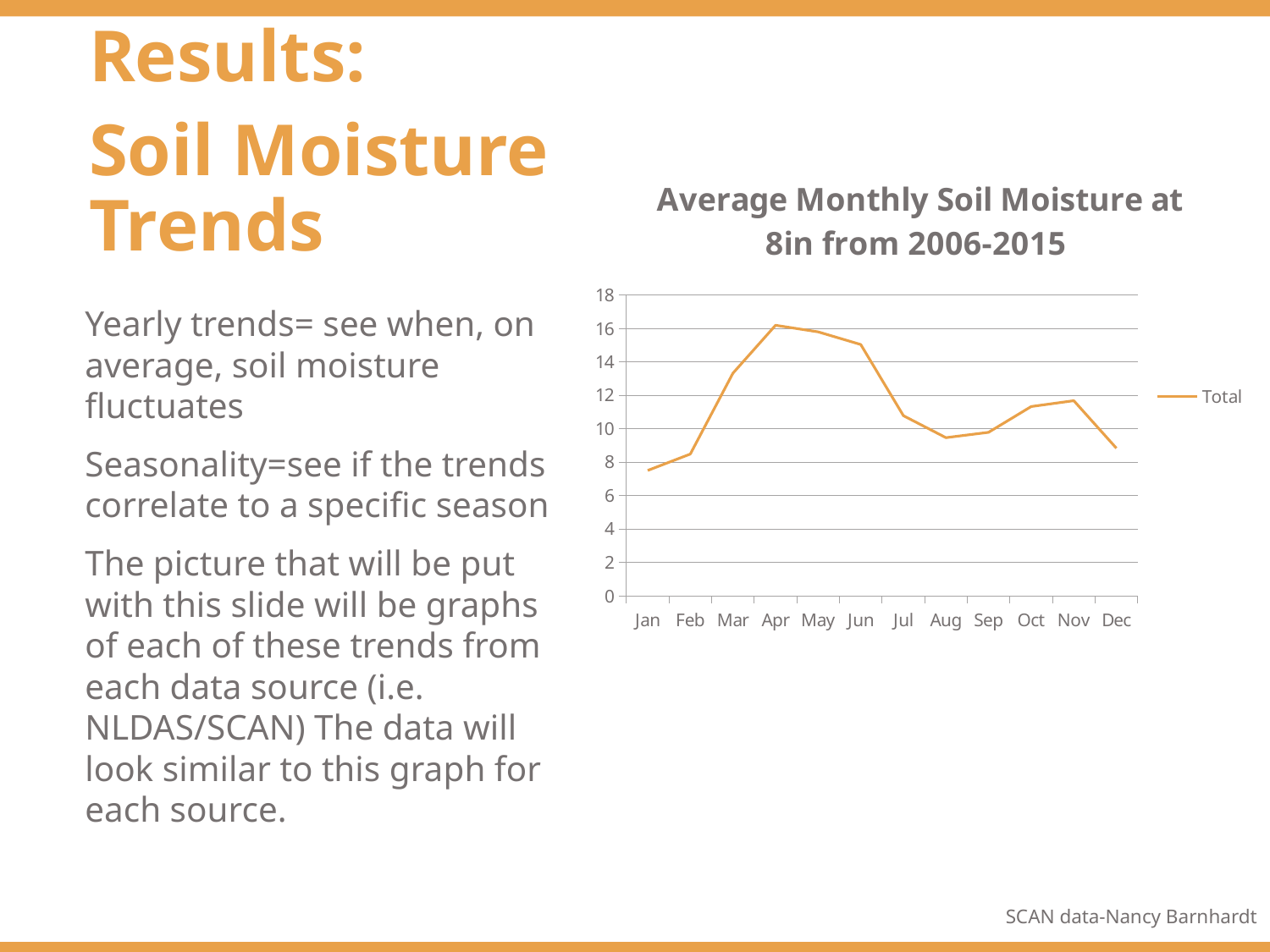
Is the value for Jun greater or less than 14? greater How many months are plotted along the x axis of the chart? 12 What is the title of the chart? Average Monthly Soil Moisture at 8in from 2006-2015 Is the value for Jan greater or less than 8? less In which month is the average soil moisture highest? Apr How many series does the chart legend list? 1 Which month has a higher value, Mar or Jul? Mar Is the value for Aug greater or less than 10? less What kind of chart is shown on the slide? line chart In which month is the average soil moisture lowest? Jan Does the soil moisture rise or fall from Jan to Apr? rise